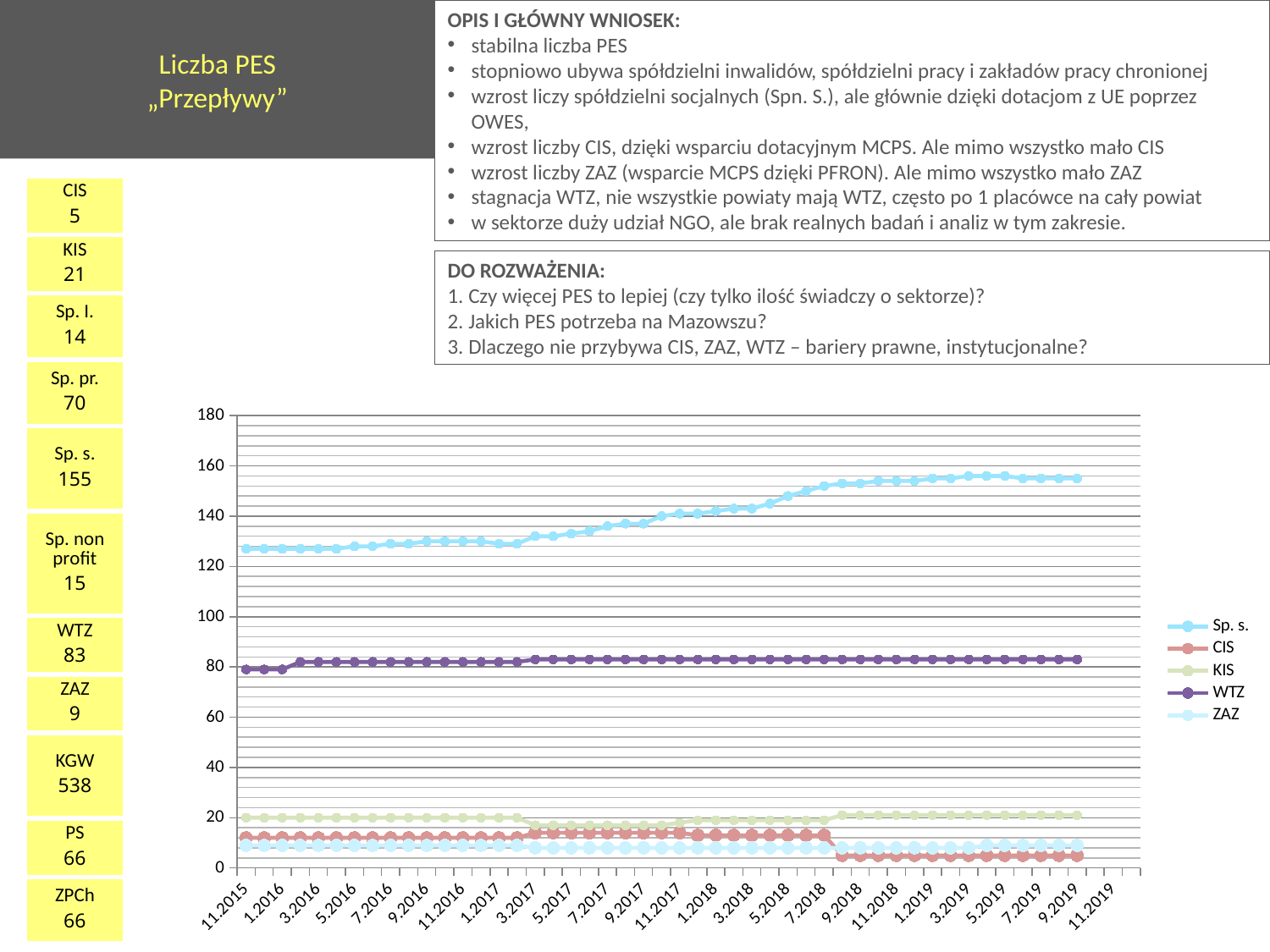
Does the CIS series rise or fall from 11.2015 to 9.2019? fall Which series is higher at 11.2015, Sp. s. or WTZ? Sp. s. Is the value for KIS at 9.2019 greater or less than 40? less Is the value for WTZ at 9.2019 greater or less than 60? greater Is the value for Sp. s. at 9.2019 greater or less than 140? greater How many series does the chart legend list? 5 What is the highest value shown on the vertical axis of the chart? 180 Does the Sp. s. series rise or fall from 11.2015 to 9.2019? rise Which series is higher at 9.2019, WTZ or KIS? WTZ What kind of chart is shown on the slide? line chart Which series has the highest values throughout the chart? Sp. s.